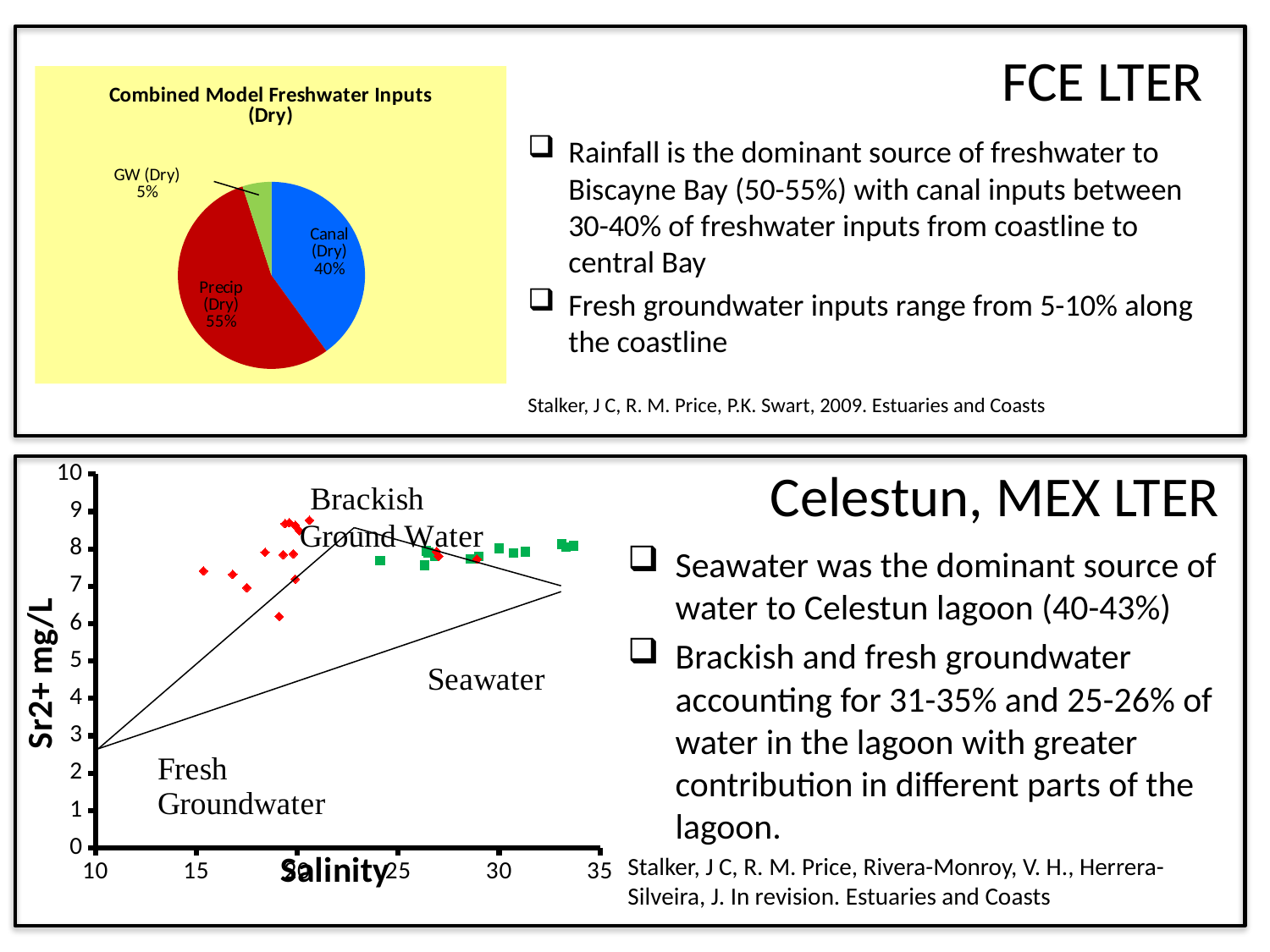
In the pie chart titled "Combined Model Freshwater Inputs (Dry)", which category has the smallest share? GW (Dry) What type of chart is the chart in the top panel of the slide? Pie chart In the pie chart titled "Combined Model Freshwater Inputs (Dry)", which category has the largest share? Precip (Dry) In the pie chart titled "Combined Model Freshwater Inputs (Dry)", what share does Precip (Dry) have? 55% In the scatter plot in the bottom panel, what is the label of the y axis? Sr2+ mg/L What type of chart is the chart in the bottom panel of the slide? Scatter plot In the pie chart titled "Combined Model Freshwater Inputs (Dry)", what is the difference between the Precip (Dry) and Canal (Dry) shares? 15% How many slices does the pie chart titled "Combined Model Freshwater Inputs (Dry)" have? 3 In the pie chart titled "Combined Model Freshwater Inputs (Dry)", which is larger, Canal (Dry) or GW (Dry)? Canal (Dry) In the pie chart titled "Combined Model Freshwater Inputs (Dry)", what share does Canal (Dry) have? 40% In the scatter plot in the bottom panel, what is the label of the x axis? Salinity In the pie chart titled "Combined Model Freshwater Inputs (Dry)", what share does GW (Dry) have? 5%